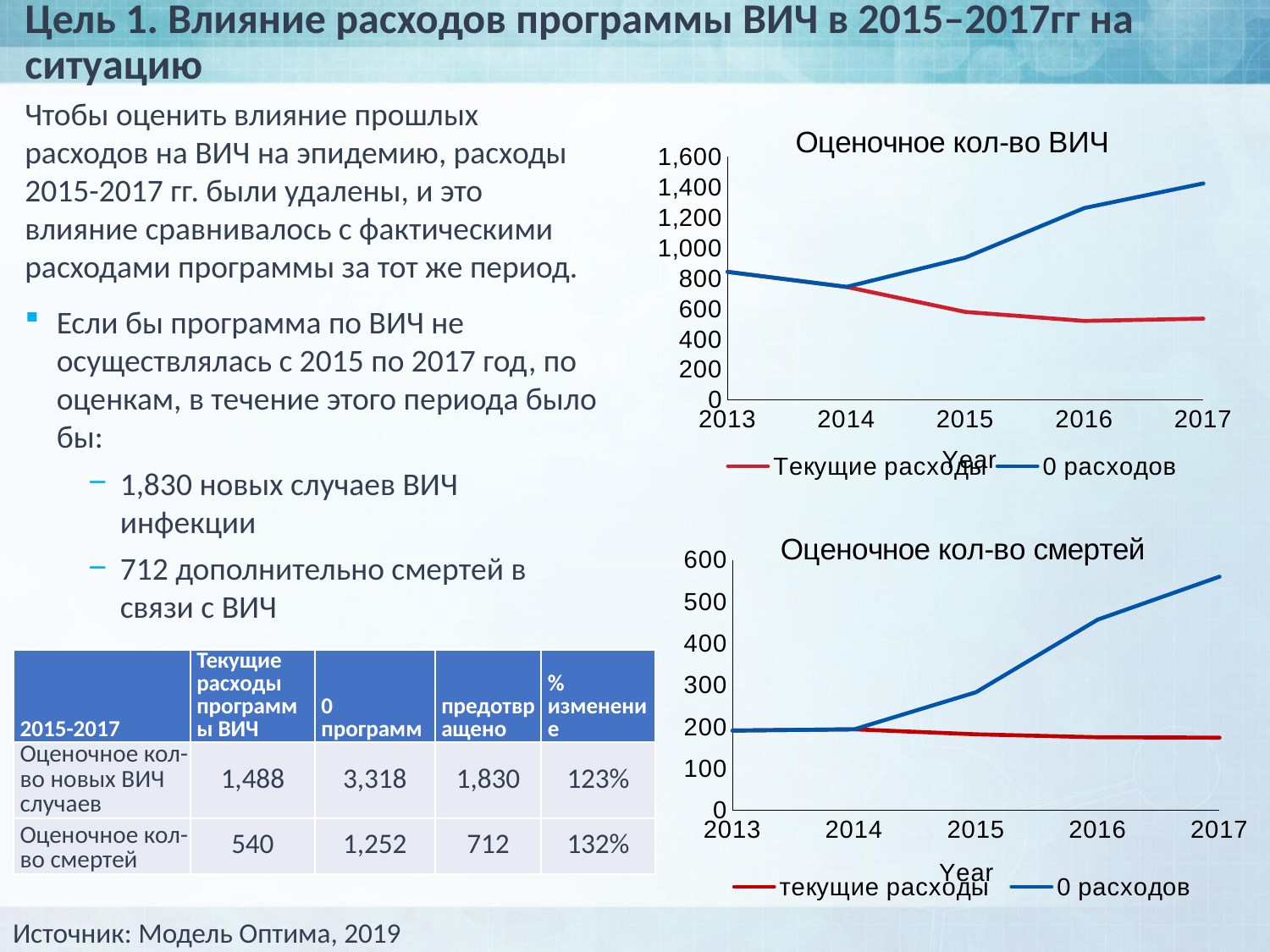
In the top chart "Оценочное кол-во ВИЧ", which series has the higher value in 2017, "Текущие расходы" or "0 расходов"? 0 расходов What is the x-axis label of the top chart "Оценочное кол-во ВИЧ"? Year What is the title of the bottom chart on the slide? Оценочное кол-во смертей In the bottom chart "Оценочное кол-во смертей", is the value for "текущие расходы" in 2016 greater or less than 300? less In the top chart "Оценочное кол-во ВИЧ", is the value for "Текущие расходы" in 2017 greater or less than 600? less What kind of chart is the top chart titled "Оценочное кол-во ВИЧ"? line chart In the bottom chart "Оценочное кол-во смертей", is the value for "0 расходов" in 2017 greater or less than 500? greater In the top chart "Оценочное кол-во ВИЧ", how many series does the legend list? 2 In the bottom chart "Оценочное кол-во смертей", does the "0 расходов" line rise or fall from 2014 to 2017? rise In the top chart "Оценочное кол-во ВИЧ", does the "Текущие расходы" line rise or fall from 2014 to 2017? fall In the top chart "Оценочное кол-во ВИЧ", how many years are shown on the x axis? 5